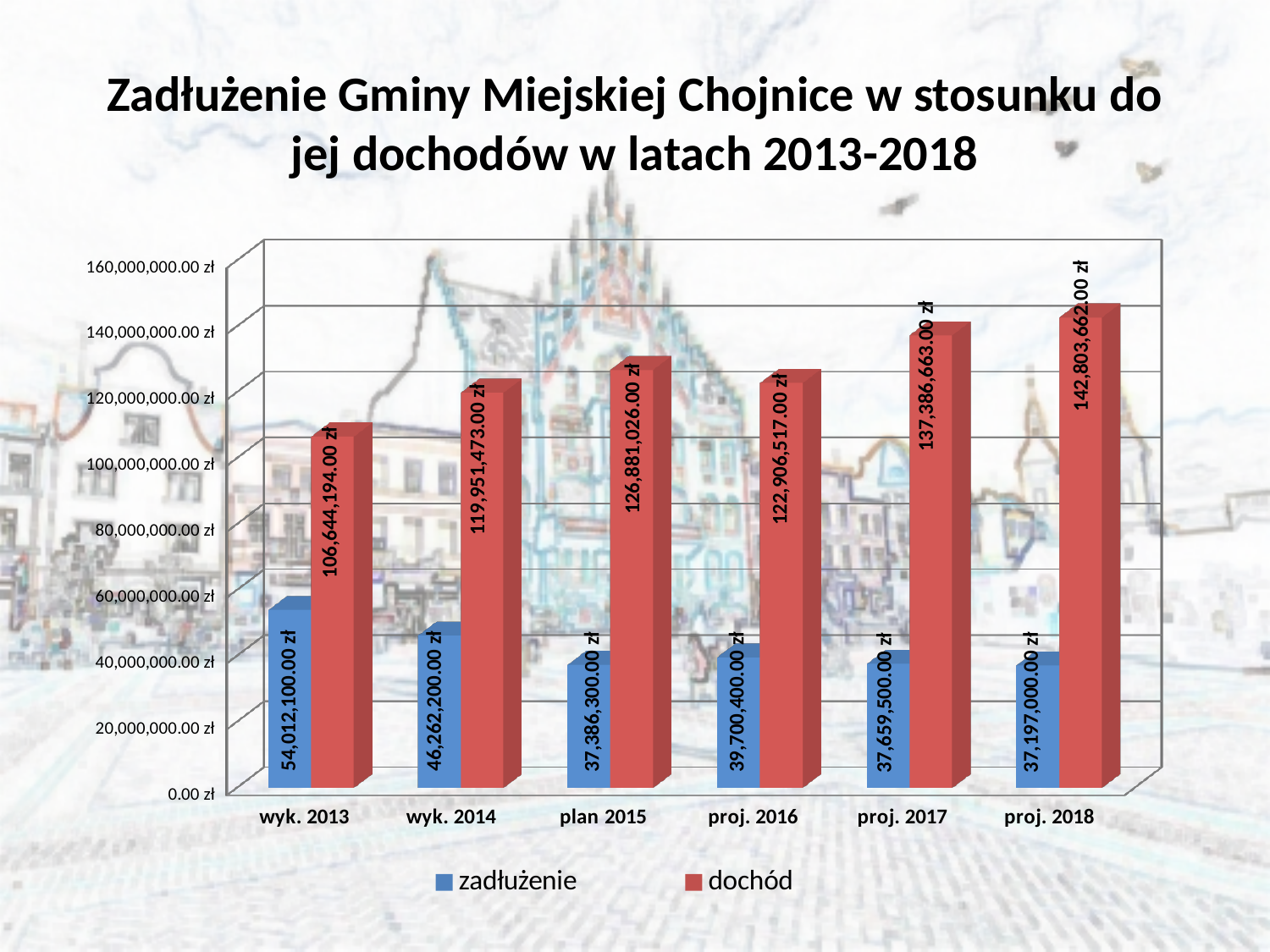
What is the zadłużenie value for plan 2015? 37,386,300.00 zł How many series does the legend list? 2 What is the zadłużenie value for wyk. 2013? 54,012,100.00 zł What is the dochód value for proj. 2018? 142,803,662.00 zł What is the difference between the dochód values for proj. 2018 and wyk. 2013? 36,159,468.00 zł What kind of chart is shown on the slide? bar chart Which category has the lowest dochód value? wyk. 2013 Which category has the lowest zadłużenie value? proj. 2018 How many categories are shown on the x axis? 6 Which is larger, the dochód value for plan 2015 or for proj. 2016? plan 2015 Which category has the highest zadłużenie value? wyk. 2013 What is the dochód value for proj. 2016? 122,906,517.00 zł